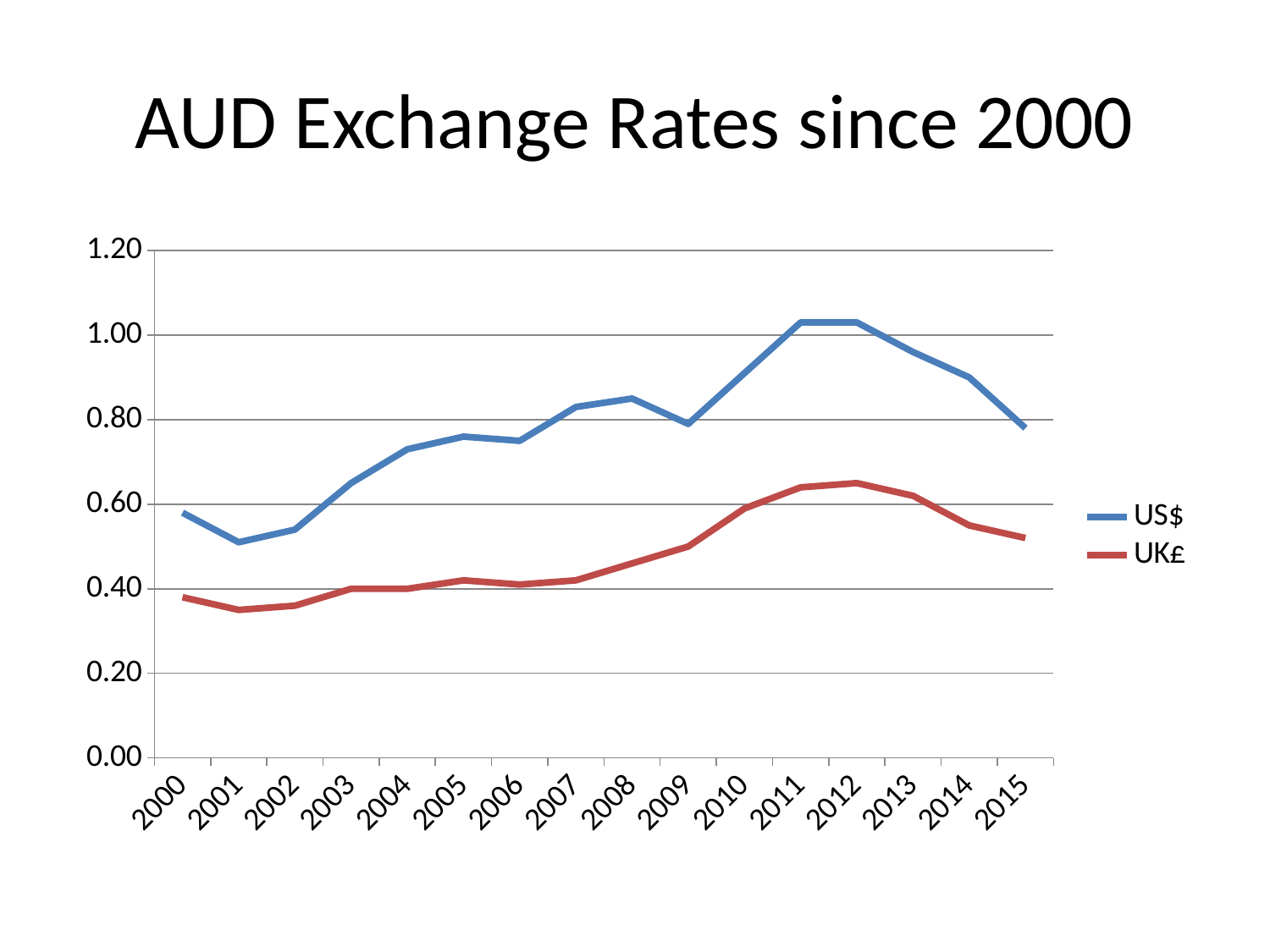
In 2010, which series has the higher value, US$ or UK£? US$ Which series is drawn in red? UK£ Does the US$ series rise or fall from 2012 to 2015? Fall What is the title of the chart? AUD Exchange Rates since 2000 How many years are plotted along the x axis? 16 Is the US$ value for 2011 greater or less than 1.00? greater How many series does the legend list? 2 Is the UK£ value for 2012 greater or less than 0.60? greater In which year is the US$ series at its lowest? 2001 Is the US$ value for 2015 greater or less than 0.80? less What kind of chart is shown on the slide? Line chart